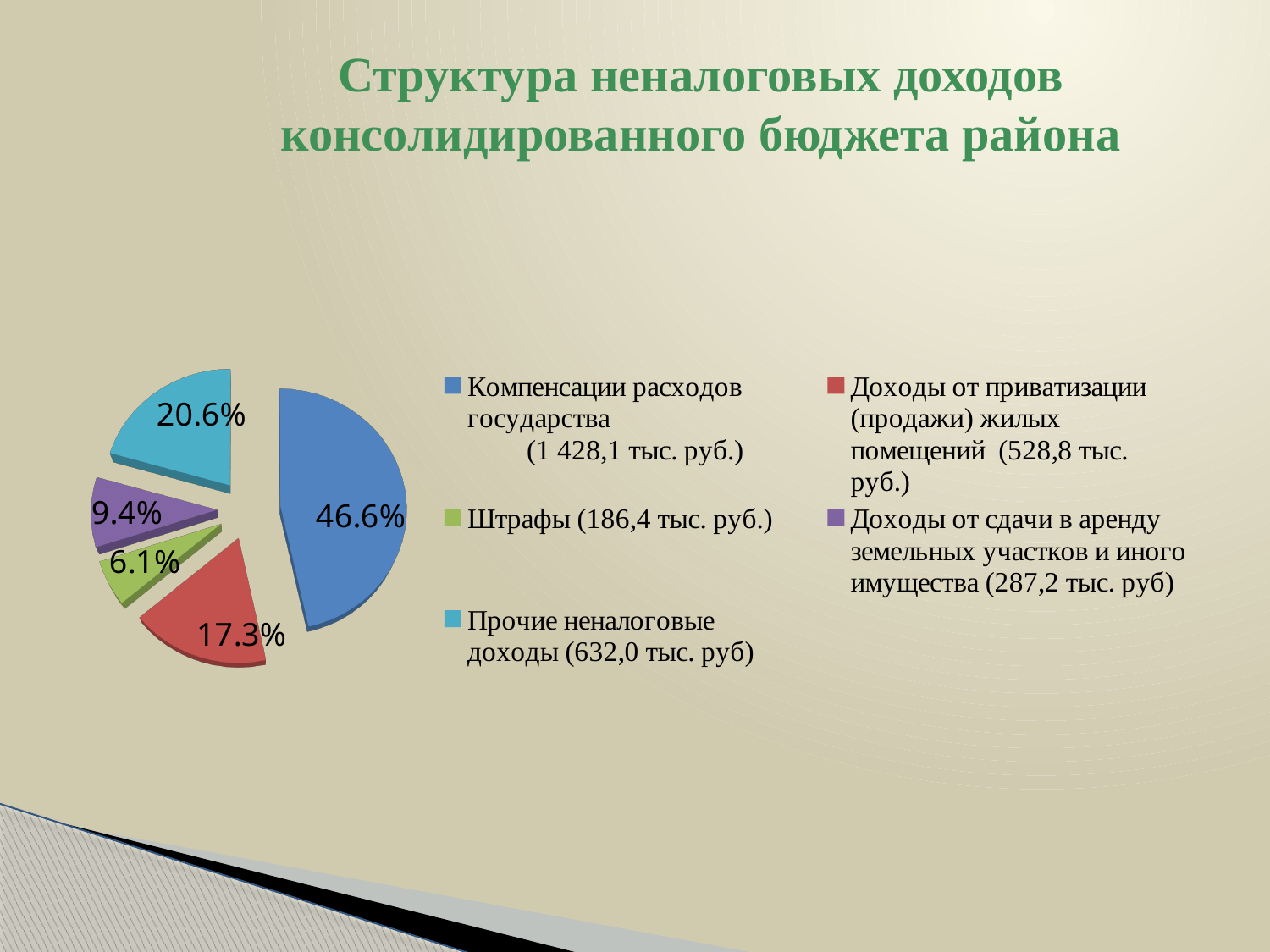
Which category has the largest slice of the pie? Компенсации расходов государства How many slices does the pie chart have? 5 What is the difference in percentage points between the "Компенсации расходов государства" slice and the "Прочие неналоговые доходы" slice? 26 percentage points What share of the pie does "Штрафы" have? 6.1% What share of the pie does "Доходы от сдачи в аренду земельных участков и иного имущества" have? 9.4% What share of the pie does "Прочие неналоговые доходы" have? 20.6% Which category has the smallest slice of the pie? Штрафы Which slice is larger: "Доходы от приватизации (продажи) жилых помещений" or "Доходы от сдачи в аренду земельных участков и иного имущества"? Доходы от приватизации (продажи) жилых помещений What kind of chart is shown on the slide? Pie chart What amount in thousand rubles is given in the legend for "Штрафы"? 186,4 тыс. руб.